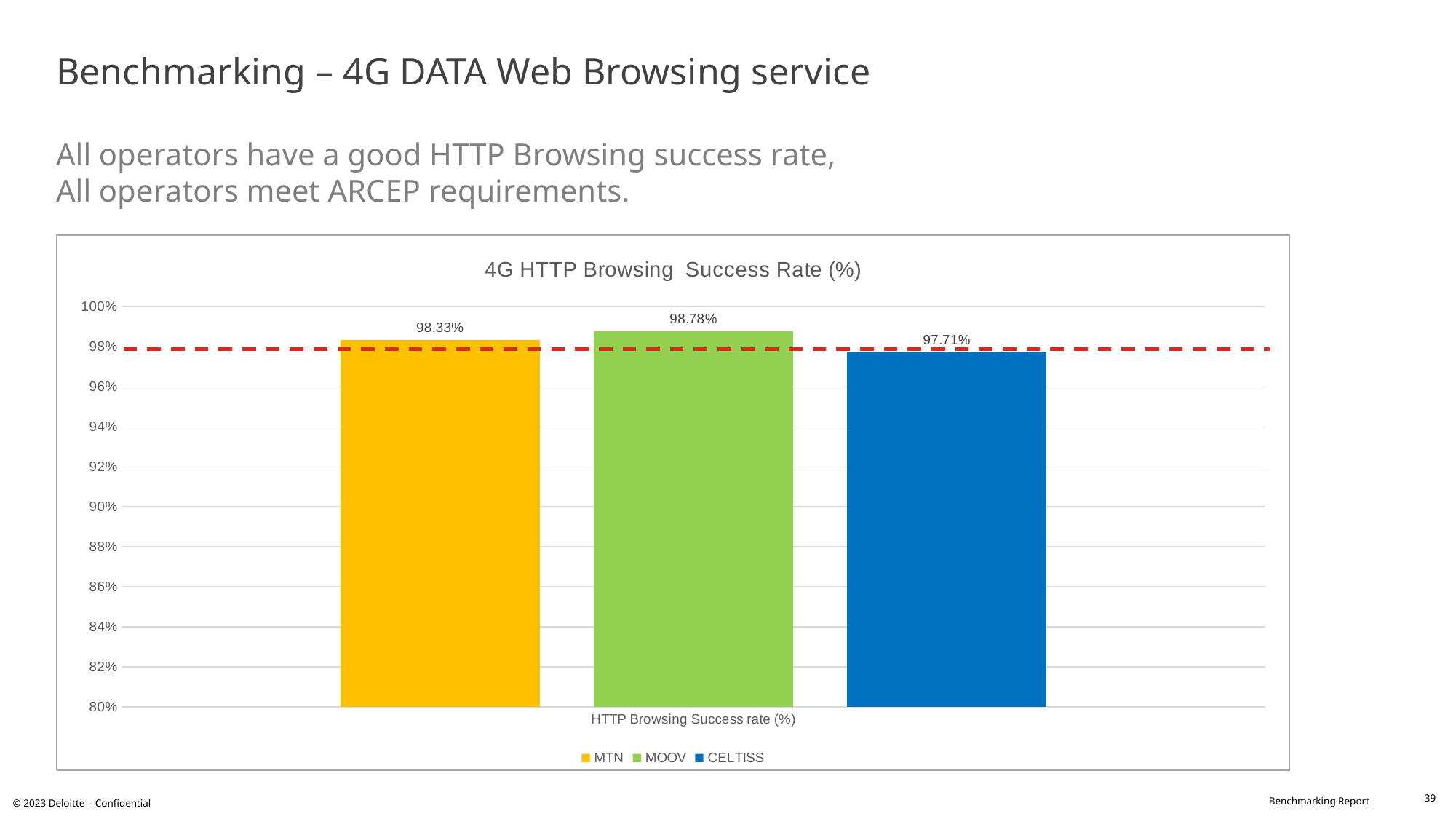
Is the value for CELTISS greater or less than 98%? less Which operator has the highest 4G HTTP Browsing success rate? MOOV What is the title of the chart? 4G HTTP Browsing Success Rate (%) What is the 4G HTTP Browsing success rate for CELTISS? 97.71% How many series does the legend list? 3 What kind of chart is shown on the slide? Bar chart What is the 4G HTTP Browsing success rate for MTN? 98.33% What is the difference in percentage points between MOOV's and MTN's HTTP Browsing success rates? 0.45 Which operator has the lowest 4G HTTP Browsing success rate? CELTISS What is the difference in percentage points between MOOV's and CELTISS's HTTP Browsing success rates? 1.07 Which has a higher HTTP Browsing success rate, MTN or CELTISS? MTN What is the 4G HTTP Browsing success rate for MOOV? 98.78%